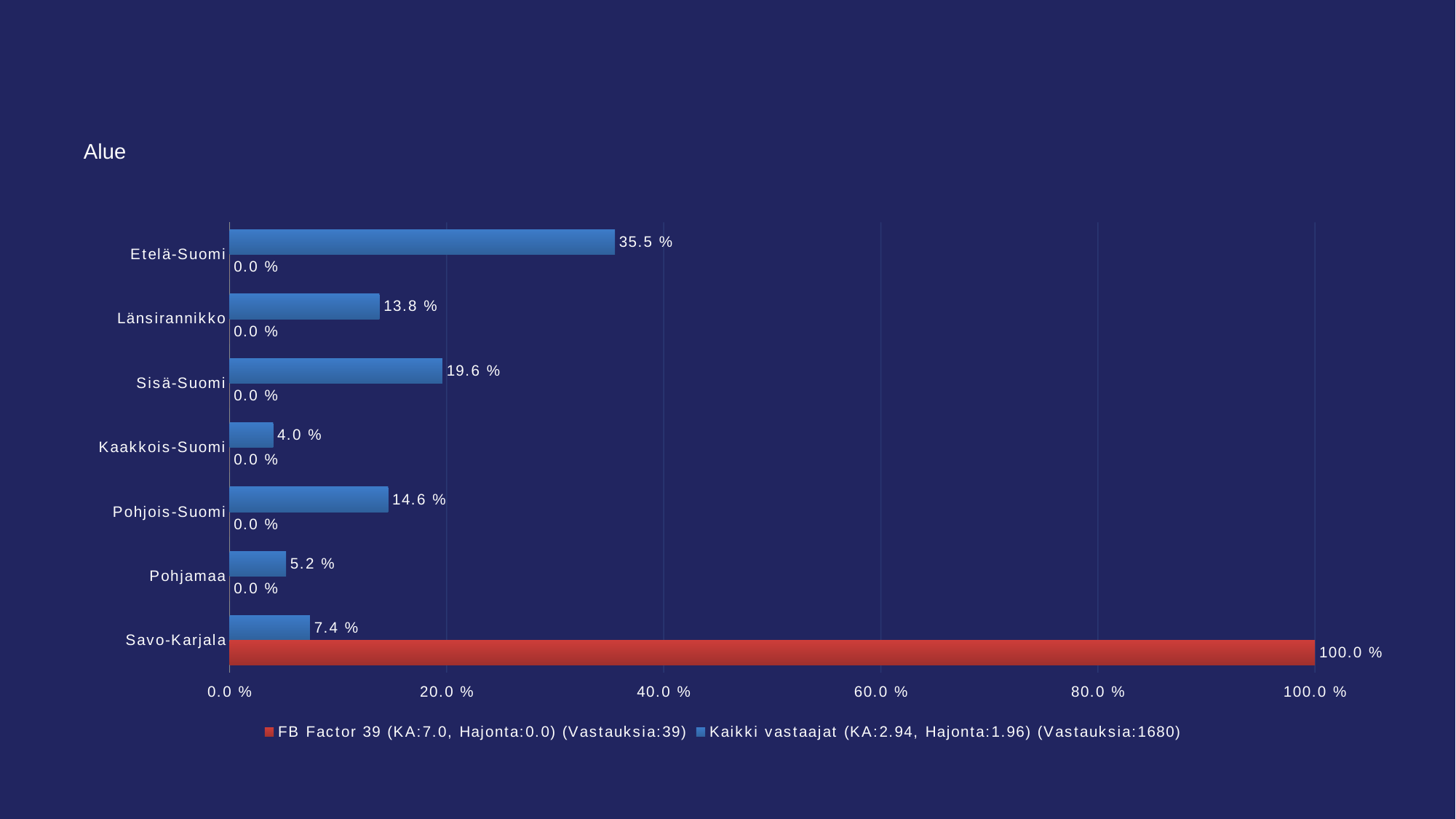
What is the value for Kaakkois-Suomi in the Kaikki vastaajat series? 4.0 % What is the difference between the Kaikki vastaajat values for Etelä-Suomi and Sisä-Suomi? 15.9 % What is the value for Etelä-Suomi in the Kaikki vastaajat series? 35.5 % What kind of chart is shown on the slide? Bar chart Which category has the highest value in the Kaikki vastaajat series? Etelä-Suomi How many series does the legend list? 2 In the Kaikki vastaajat series, which is larger: Länsirannikko or Pohjois-Suomi? Pohjois-Suomi Which category has the lowest value in the Kaikki vastaajat series? Kaakkois-Suomi What is the title of the chart? Alue How many categories are shown on the chart? 7 What is the value for Savo-Karjala in the FB Factor 39 series? 100.0 % What is the value for Pohjamaa in the FB Factor 39 series? 0.0 %